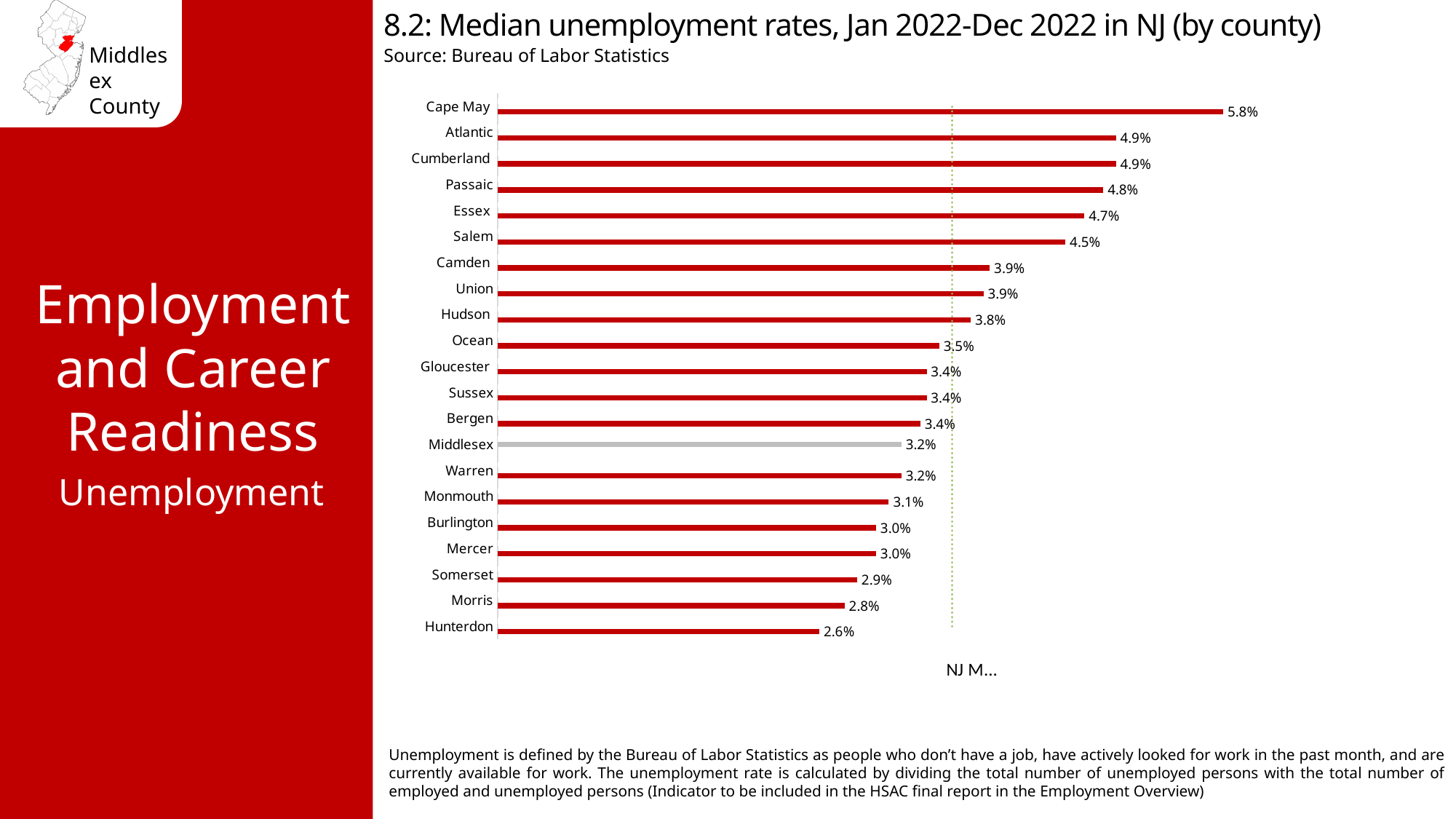
What is the median unemployment rate for Cape May? 5.8% What is the difference between the median unemployment rates of Essex and Middlesex? 1.5% Which county has a higher median unemployment rate, Salem or Camden? Salem Which county has a higher median unemployment rate, Morris or Somerset? Somerset What is the median unemployment rate for Hudson? 3.8% How many counties are shown in the chart? 21 Which county's bar is shown in gray instead of red? Middlesex Which county has the highest median unemployment rate? Cape May What is the median unemployment rate for Middlesex County? 3.2% What is the difference between the median unemployment rates of Cape May and Hunterdon? 3.2% What type of chart is used to show the median unemployment rates? Bar chart Which county has the lowest median unemployment rate? Hunterdon